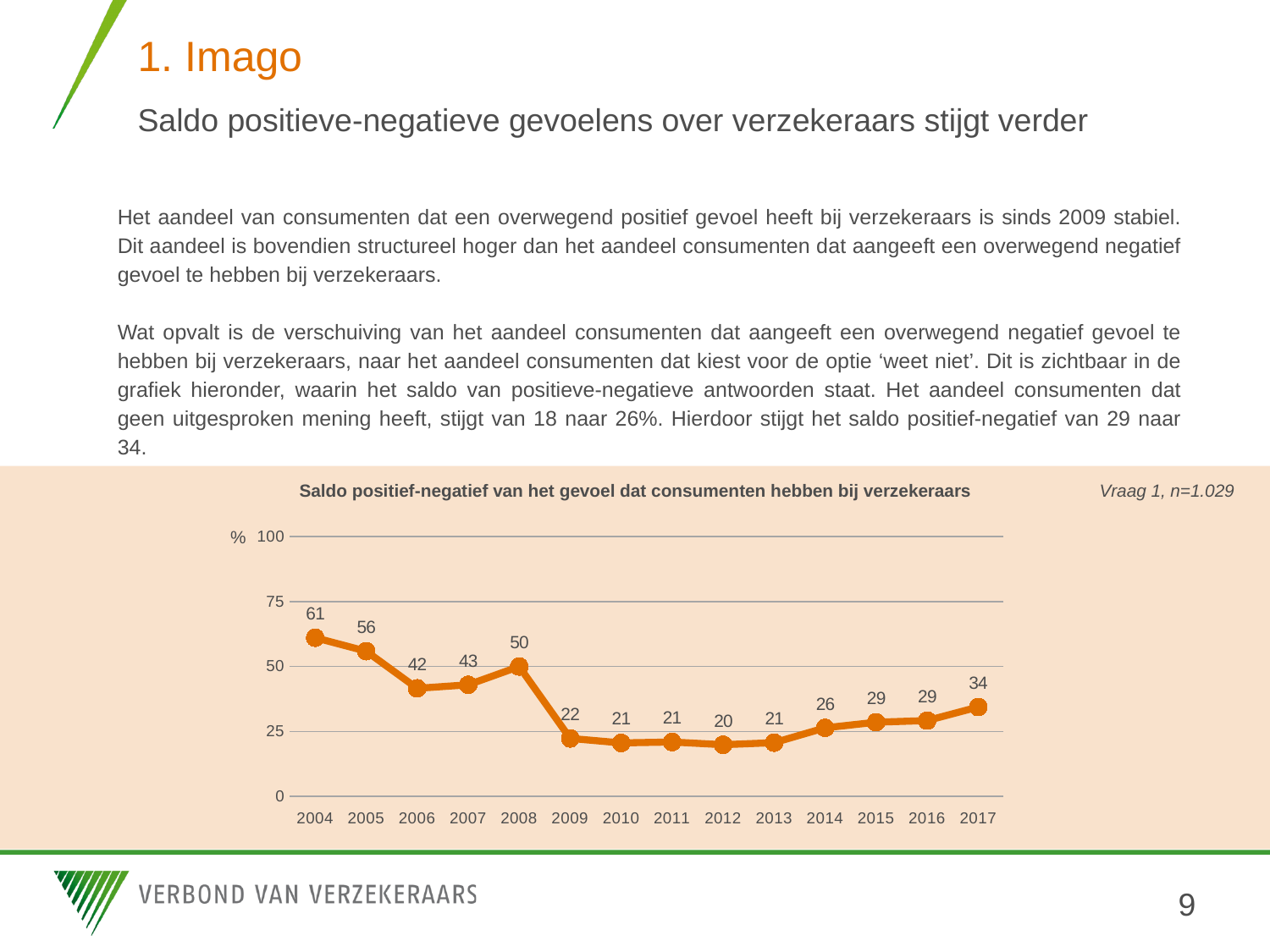
Which year has the highest value? 2004 What is the difference between the values for 2008 and 2009? 28 Which is larger, the value for 2006 or the value for 2007? 2007 What is the difference between the values for 2004 and 2017? 27 What is the value for 2008? 50 What is the value for 2017? 34 What is the title of the chart? Saldo positief-negatief van het gevoel dat consumenten hebben bij verzekeraars What kind of chart is shown on the slide? line chart What is the value for 2004? 61 Is the value for 2005 greater or less than 50? greater Which year has the lowest value? 2012 How many years are plotted on the chart? 14